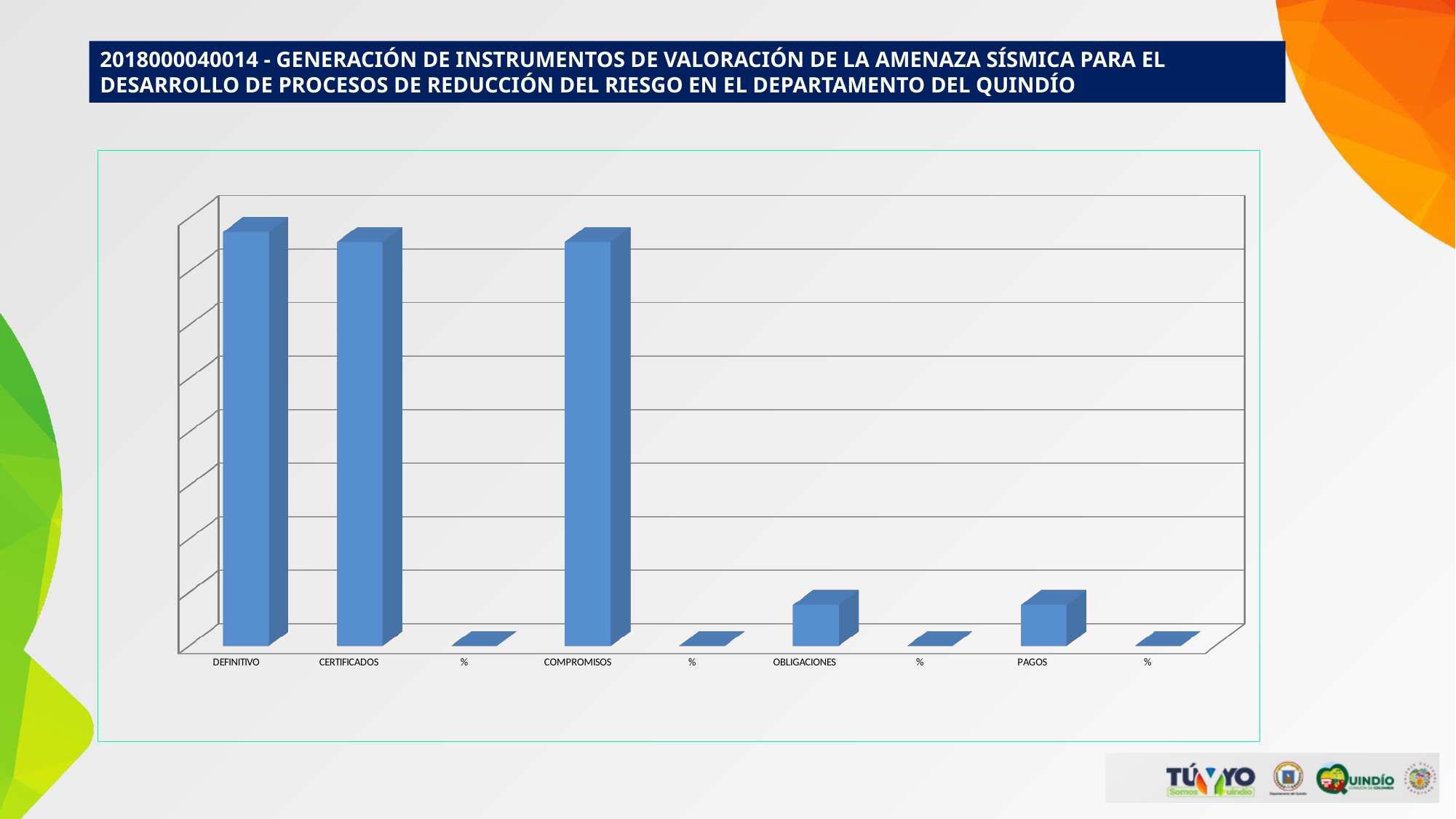
Which is larger, the value for COMPROMISOS or the value for PAGOS? COMPROMISOS Is the bar for OBLIGACIONES taller or shorter than the bar for COMPROMISOS? shorter Which is larger, the value for CERTIFICADOS or the value for OBLIGACIONES? CERTIFICADOS How many categories are shown along the x axis of the chart? 9 How many categories on the x axis are labelled "%"? 4 What kind of chart is shown on the slide? bar chart What colour are the bars in the chart? blue What is the label of the first category on the x axis of the chart? DEFINITIVO